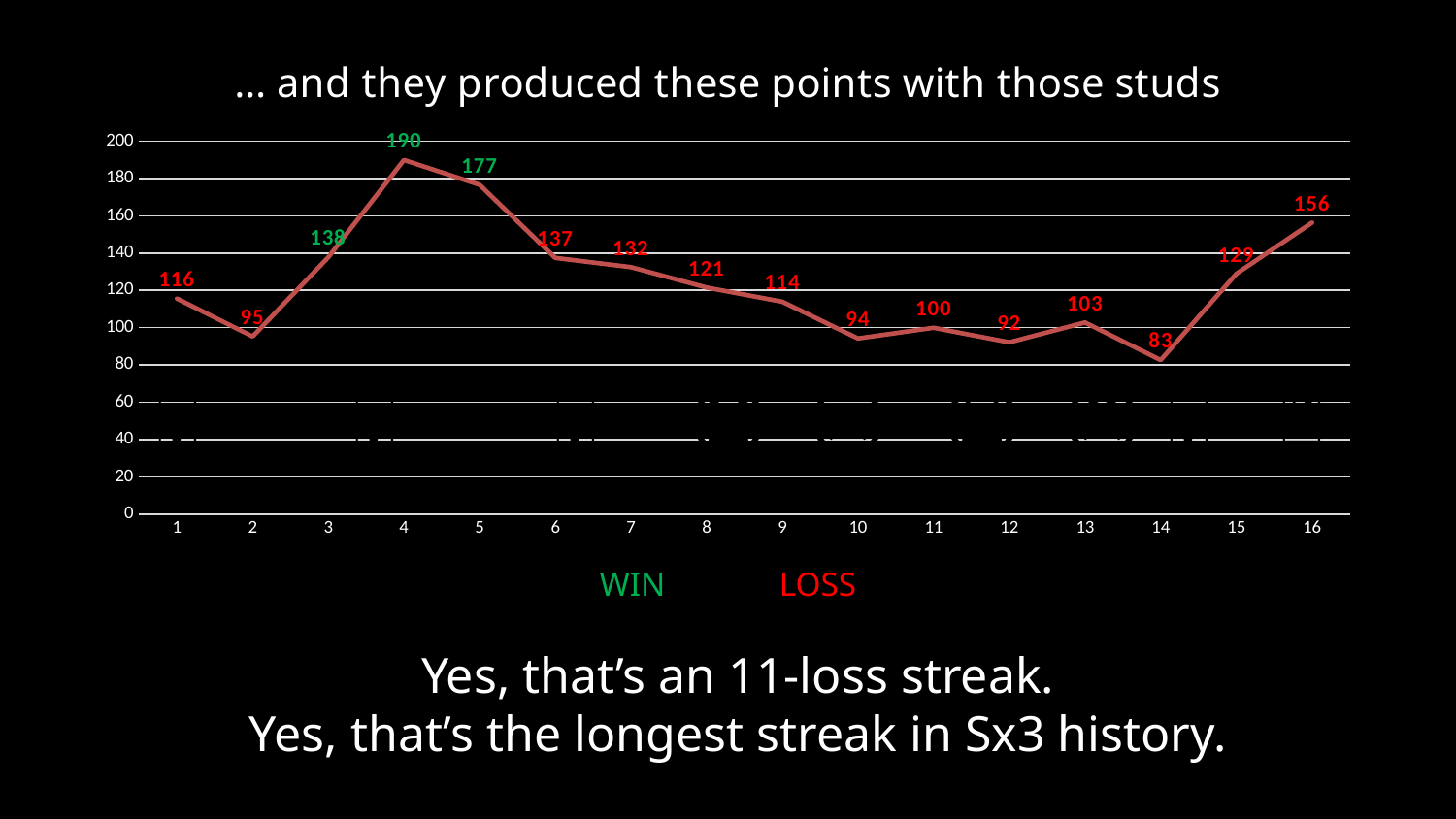
What colour are the data labels for wins? green What is the value at point 14? 83 How many points are plotted on the line chart? 16 Is the value at point 5 greater or less than 160? greater Which point has the lowest value? 14 What kind of chart is shown on the slide? line chart Do the values rise or fall from point 5 to point 10? fall Which point has the highest value? 4 What is the value at point 4? 190 What is the value at point 16? 156 Which is larger, the value at point 1 or the value at point 2? point 1 What is the difference between the values at point 4 and point 5? 13